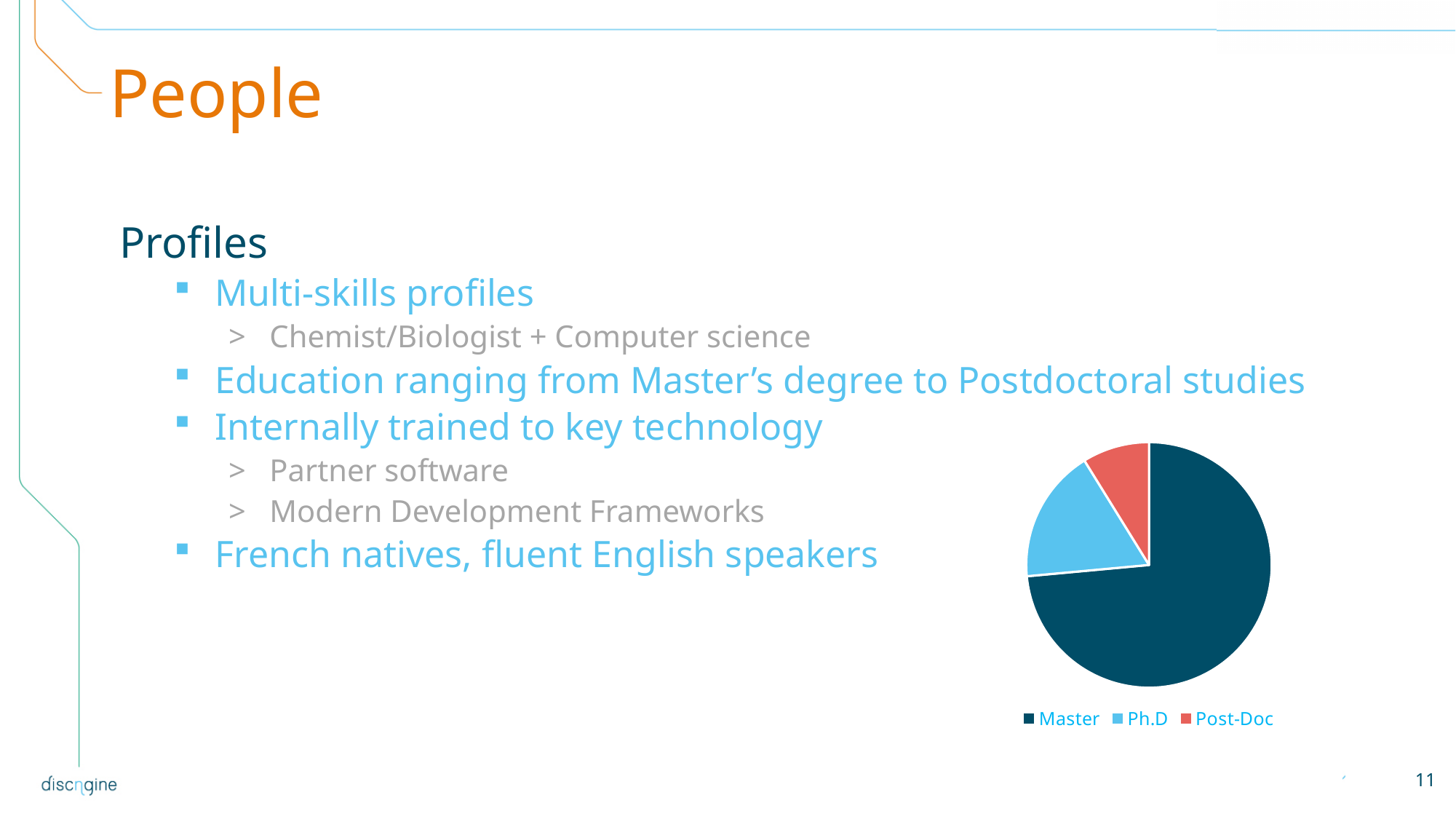
What colour is the Post-Doc slice in the pie chart? red Which slice is larger in the pie chart, Ph.D or Post-Doc? Ph.D What kind of chart is shown on the slide? pie chart How many entries does the legend of the pie chart list? 3 How many slices does the pie chart have? 3 Does the Master slice take up more or less than half of the pie chart? more Which slice is larger in the pie chart, Master or Ph.D? Master Which category has the largest slice in the pie chart? Master Which category is shown in light blue in the pie chart? Ph.D Which category has the smallest slice in the pie chart? Post-Doc